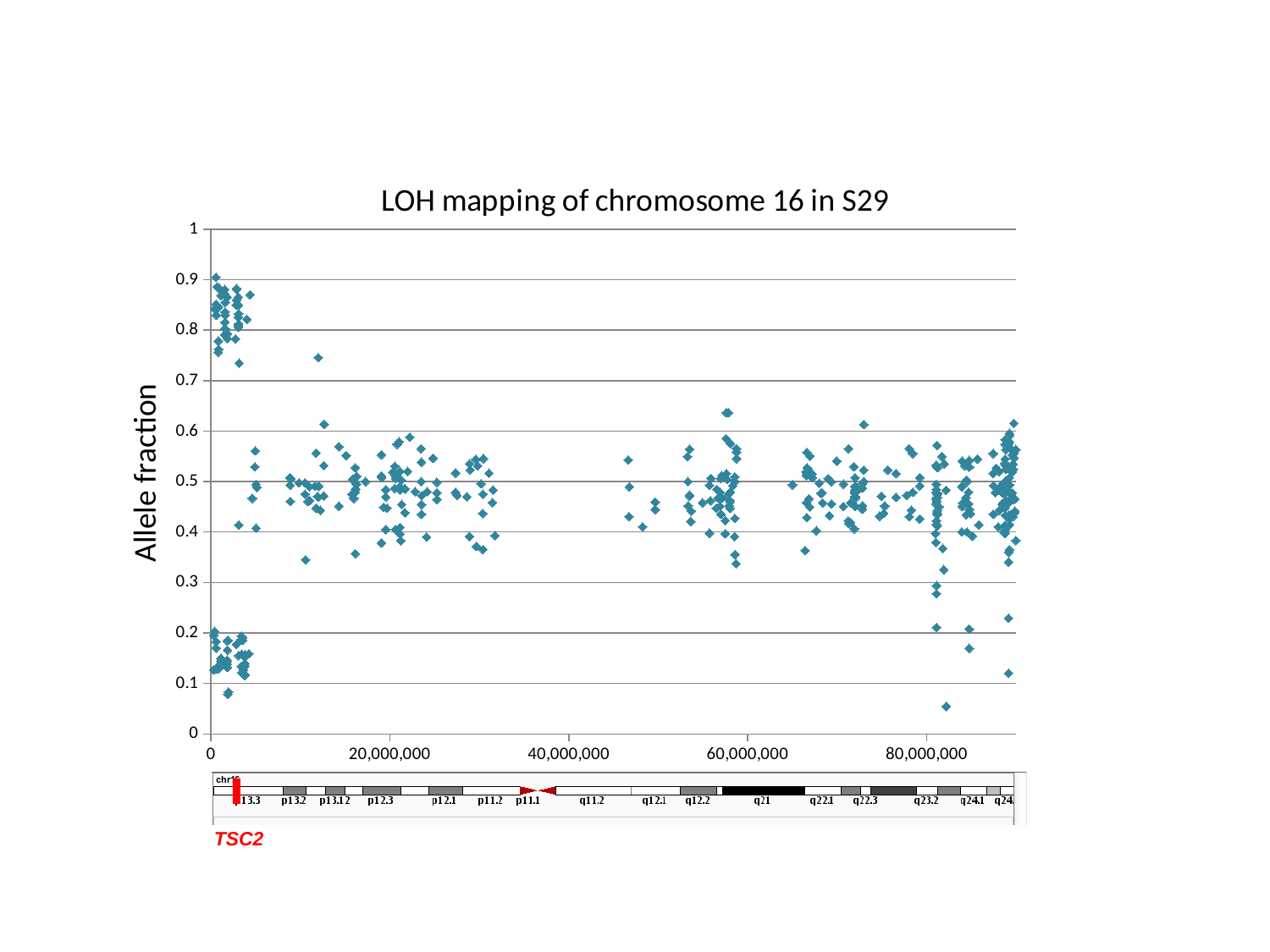
Is the lowest plotted allele fraction greater or less than 0.1? less Is the allele fraction of the single point plotted near 12,000,000 above the main band greater or less than 0.7? greater Is the highest plotted allele fraction greater or less than 0.8? greater What kind of chart is shown on the slide? scatter plot What is the title of the chart? LOH mapping of chromosome 16 in S29 What is the label on the y axis of the chart? Allele fraction